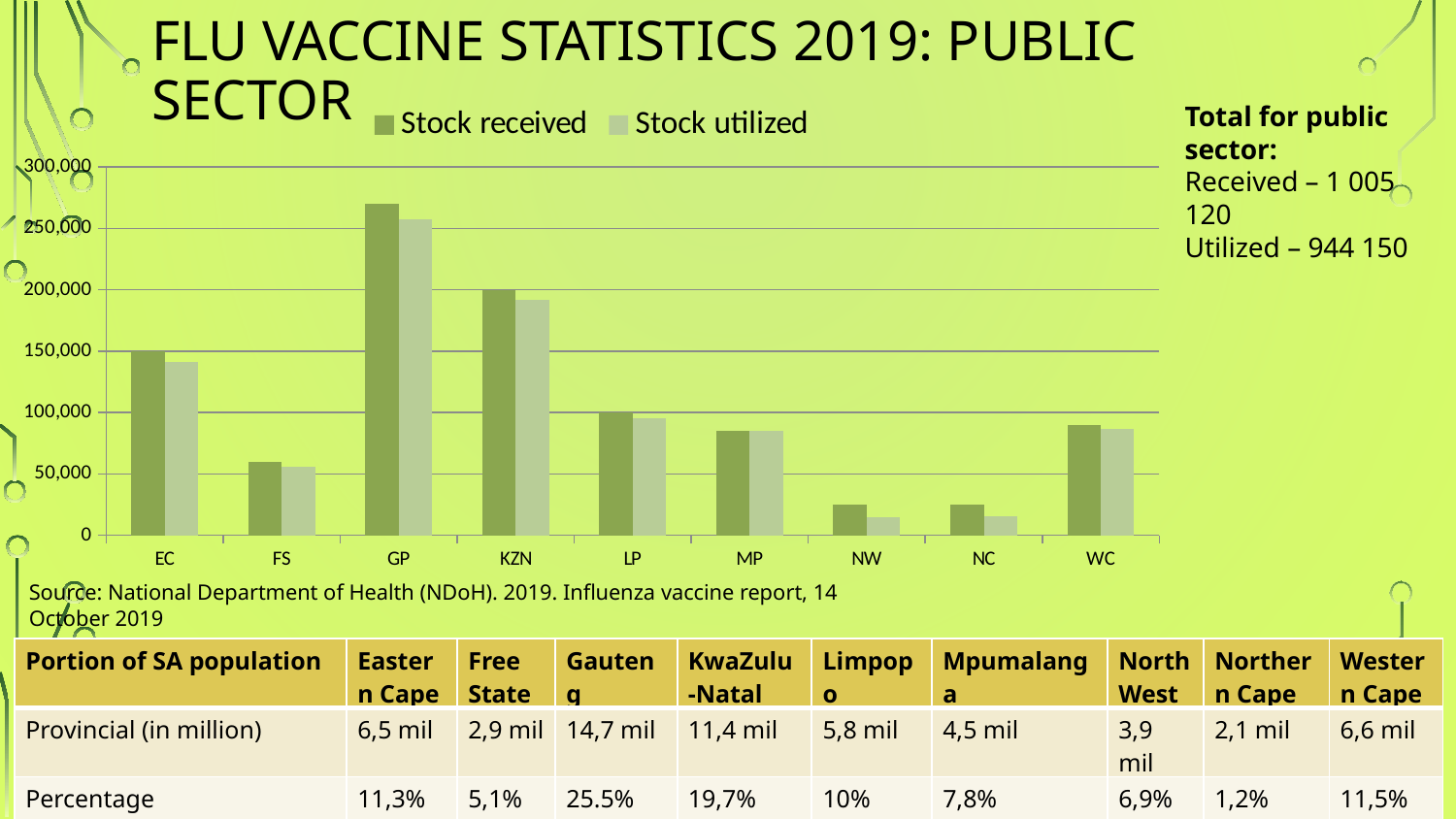
Which is larger, the stock received for KZN or the stock received for EC? KZN How many provinces are shown on the x axis of the chart? 9 Is the stock received for FS greater or less than 100,000? less Which province has the highest stock utilized? GP Which is larger, the stock utilized for WC or the stock utilized for FS? WC What are the two series named in the chart legend? Stock received and Stock utilized How many series does the chart legend list? 2 Is the stock utilized for KZN greater or less than 150,000? greater Which province has the highest stock received? GP Is the stock received for GP greater or less than 250,000? greater What kind of chart is shown on the slide? bar chart